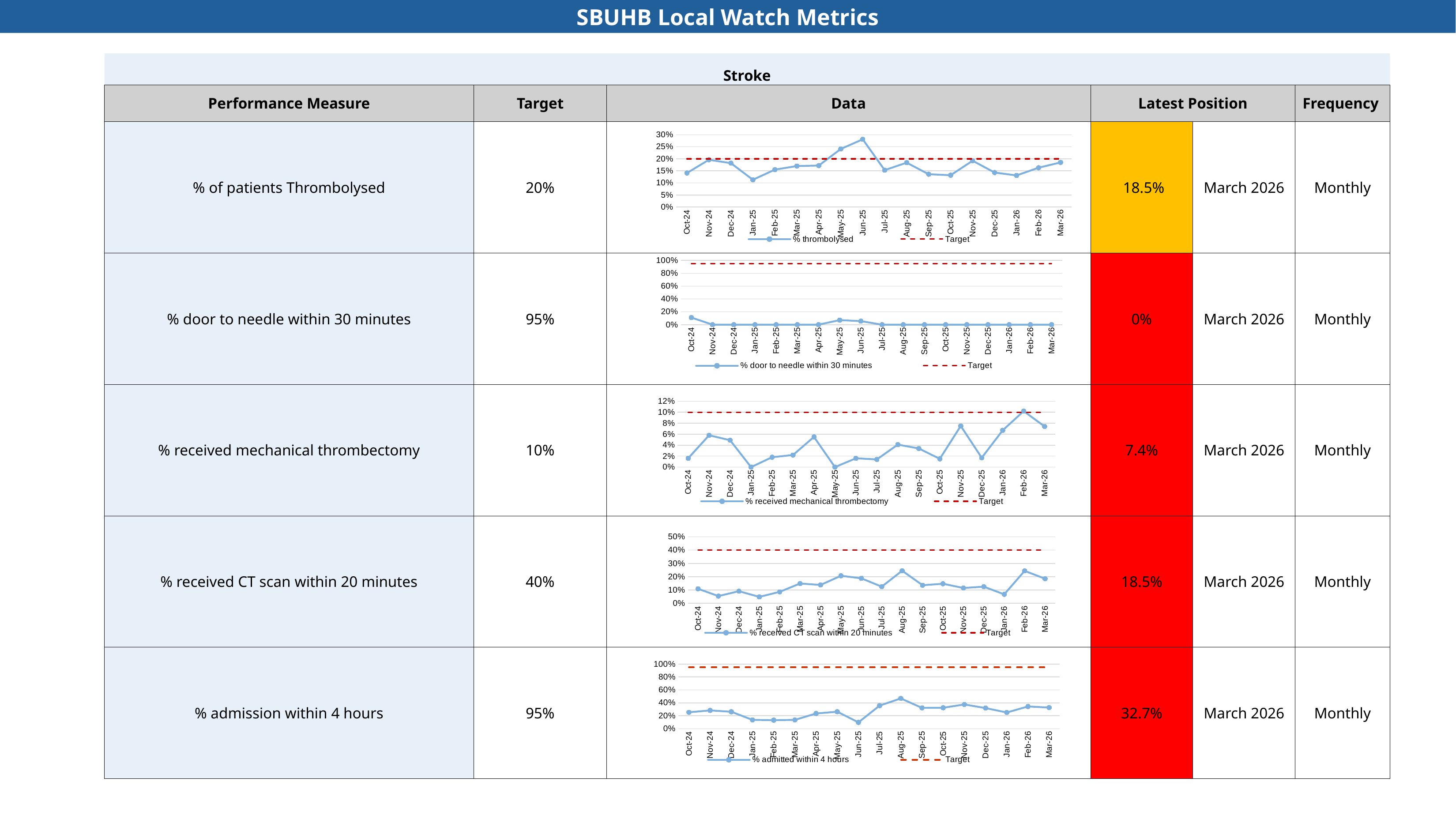
What kind of chart is shown in the Data column for '% of patients Thrombolysed'? Line chart In the '% of patients Thrombolysed' chart, is the value for Jun-25 greater or less than 25%? greater In the '% received CT scan within 20 minutes' chart, which is larger: the value for Aug-25 or the value for Nov-24? Aug-25 In the '% door to needle within 30 minutes' chart, which month has the highest value? Oct-24 In the '% of patients Thrombolysed' chart, which month has the lowest value? Jan-25 In the '% admission within 4 hours' chart, is the value for Aug-25 greater or less than 40%? greater In the '% received mechanical thrombectomy' chart, is the value for Nov-25 greater or less than 10%? less How many series does the legend of the '% door to needle within 30 minutes' chart list? 2 In the '% received mechanical thrombectomy' chart, which month has the highest value? Feb-26 How many months are plotted on the x axis of the '% door to needle within 30 minutes' chart? 18 In the '% of patients Thrombolysed' chart, which month has the highest value? Jun-25